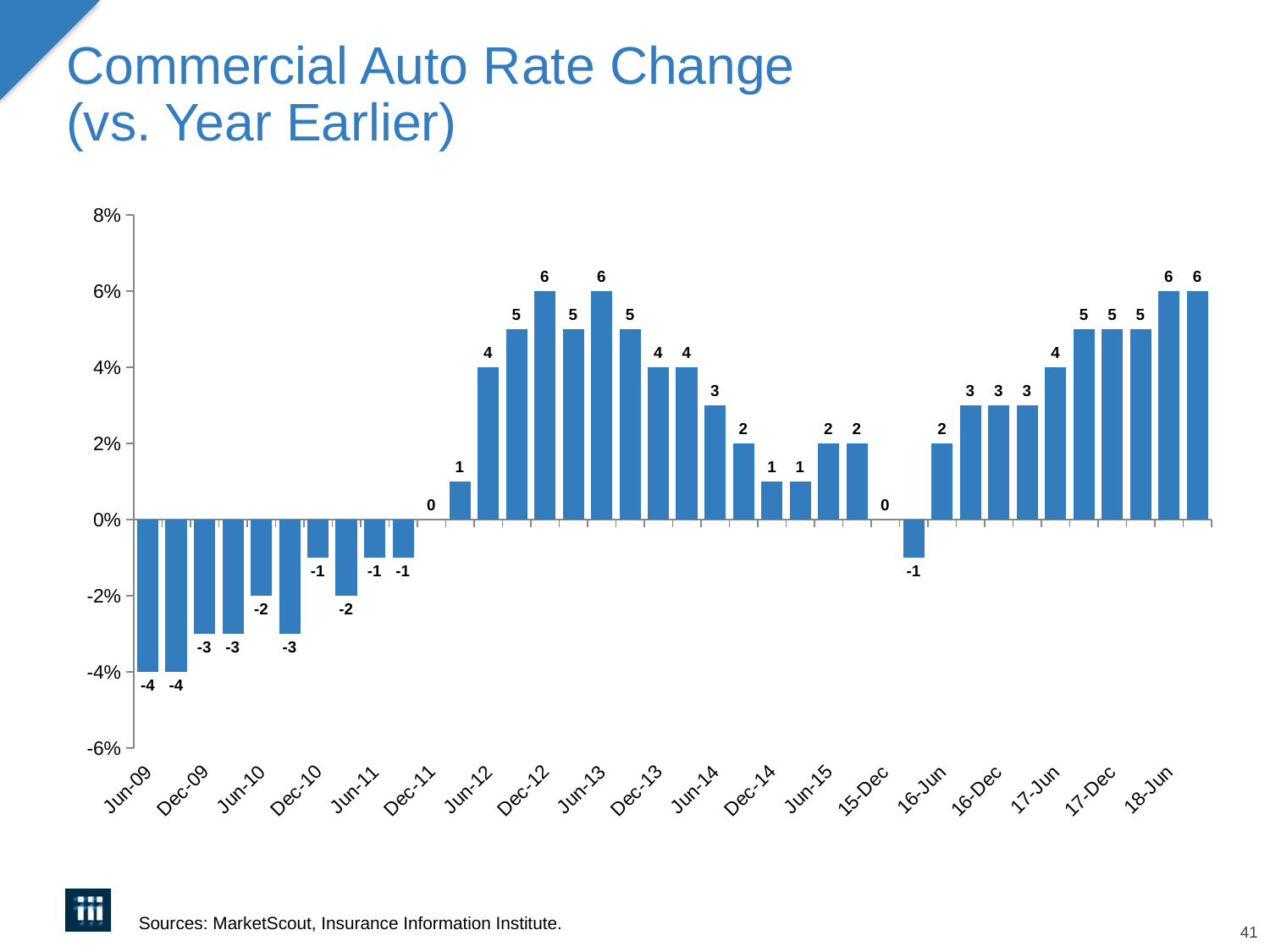
Is the value for Dec-12 greater or less than 4%? greater What is the commercial auto rate change for Dec-11? 0 What is the commercial auto rate change for Jun-09? -4 What is the difference between the rate change for Jun-13 and Jun-14? 3 What is the lowest rate change value shown on the chart? -4 What is the highest rate change value shown on the chart? 6 Which has the larger rate change, Dec-09 or Jun-10? Jun-10 Do the values rise or fall from Jun-09 to Jun-12? Rise What is the commercial auto rate change for Dec-12? 6 What is the commercial auto rate change for 17-Dec? 5 What kind of chart is shown on the slide? Bar chart What is the title of the chart? Commercial Auto Rate Change (vs. Year Earlier)